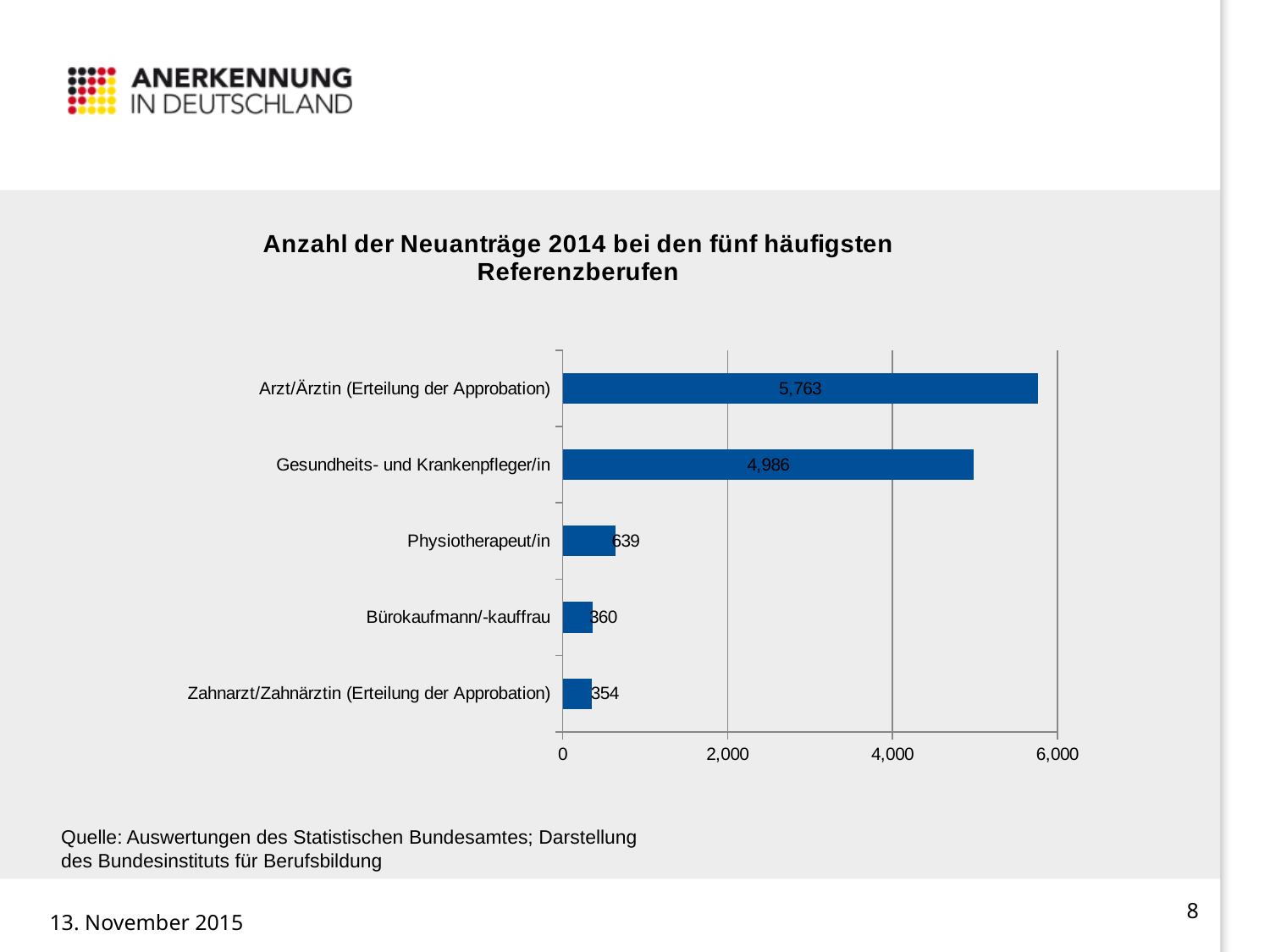
What is the value shown for Physiotherapeut/in? 639 What is the difference between the values for Physiotherapeut/in and Bürokaufmann/-kauffrau? 279 What is the number of new applications for Arzt/Ärztin (Erteilung der Approbation)? 5,763 How many reference occupations are shown in the chart? 5 What is the difference between the values for Arzt/Ärztin (Erteilung der Approbation) and Gesundheits- und Krankenpfleger/in? 777 What type of chart is shown on the slide? Bar chart What is the value shown for Zahnarzt/Zahnärztin (Erteilung der Approbation)? 354 What is the value shown for Gesundheits- und Krankenpfleger/in? 4,986 Which has a larger value, Gesundheits- und Krankenpfleger/in or Physiotherapeut/in? Gesundheits- und Krankenpfleger/in Which reference occupation has the highest number of new applications? Arzt/Ärztin (Erteilung der Approbation) Is the value for Gesundheits- und Krankenpfleger/in greater or less than 4,000? greater Which reference occupation has the lowest number of new applications? Zahnarzt/Zahnärztin (Erteilung der Approbation)